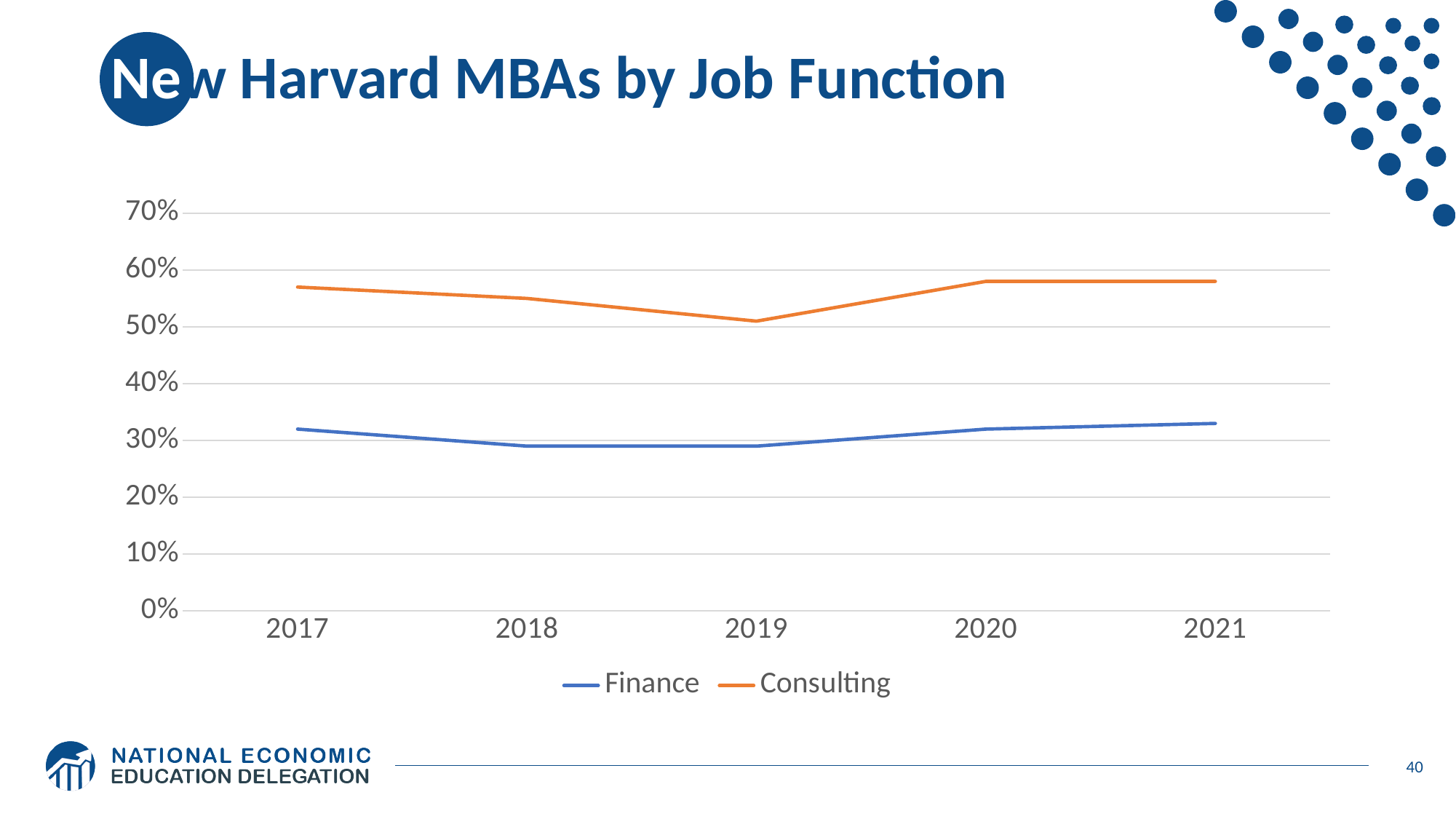
What colour is the Consulting line? Orange Does the Consulting series rise or fall from 2019 to 2020? Rise How many years are plotted along the x axis? 5 In which year is the Consulting series at its lowest? 2019 Which series has the higher value in 2019, Finance or Consulting? Consulting What kind of chart is shown on the slide? Line chart Is the value for Finance in 2019 greater or less than 40%? less Is the value for Consulting in 2020 greater or less than 60%? less Is the value for Consulting in 2017 greater or less than 50%? greater How many series does the legend list? 2 Does the Finance series rise or fall from 2017 to 2018? Fall